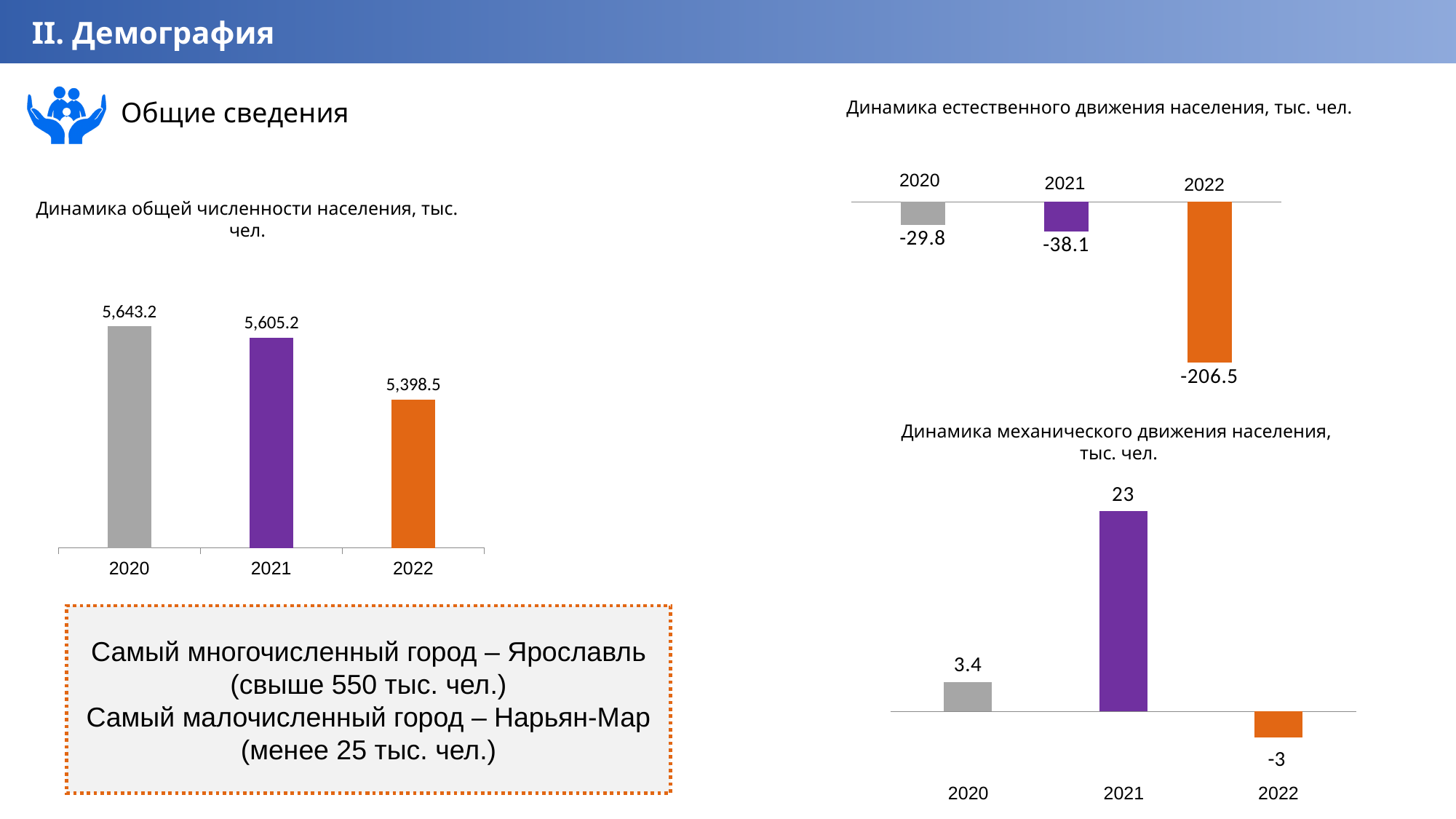
In the chart 'Динамика механического движения населения, тыс. чел.', what is the difference between the 2021 and 2020 values? 19.6 In the chart 'Динамика механического движения населения, тыс. чел.', which year has the highest value? 2021 In the chart 'Динамика общей численности населения, тыс. чел.', do the values rise or fall from 2020 to 2022? fall In the chart 'Динамика естественного движения населения, тыс. чел.', what is the value for 2021? -38.1 In the chart 'Динамика общей численности населения, тыс. чел.', what is the difference between the 2021 and 2022 values? 206.7 In the chart 'Динамика общей численности населения, тыс. чел.', which year has the lowest value? 2022 What type of chart is 'Динамика общей численности населения, тыс. чел.'? bar chart In the chart 'Динамика общей численности населения, тыс. чел.', what is the value for 2020? 5,643.2 In the chart 'Динамика естественного движения населения, тыс. чел.', how many years are shown? 3 In the chart 'Динамика механического движения населения, тыс. чел.', what is the value for 2021? 23 In the chart 'Динамика естественного движения населения, тыс. чел.', which year has the lowest value? 2022 In the chart 'Динамика механического движения населения, тыс. чел.', which is larger, the value for 2020 or the value for 2022? 2020